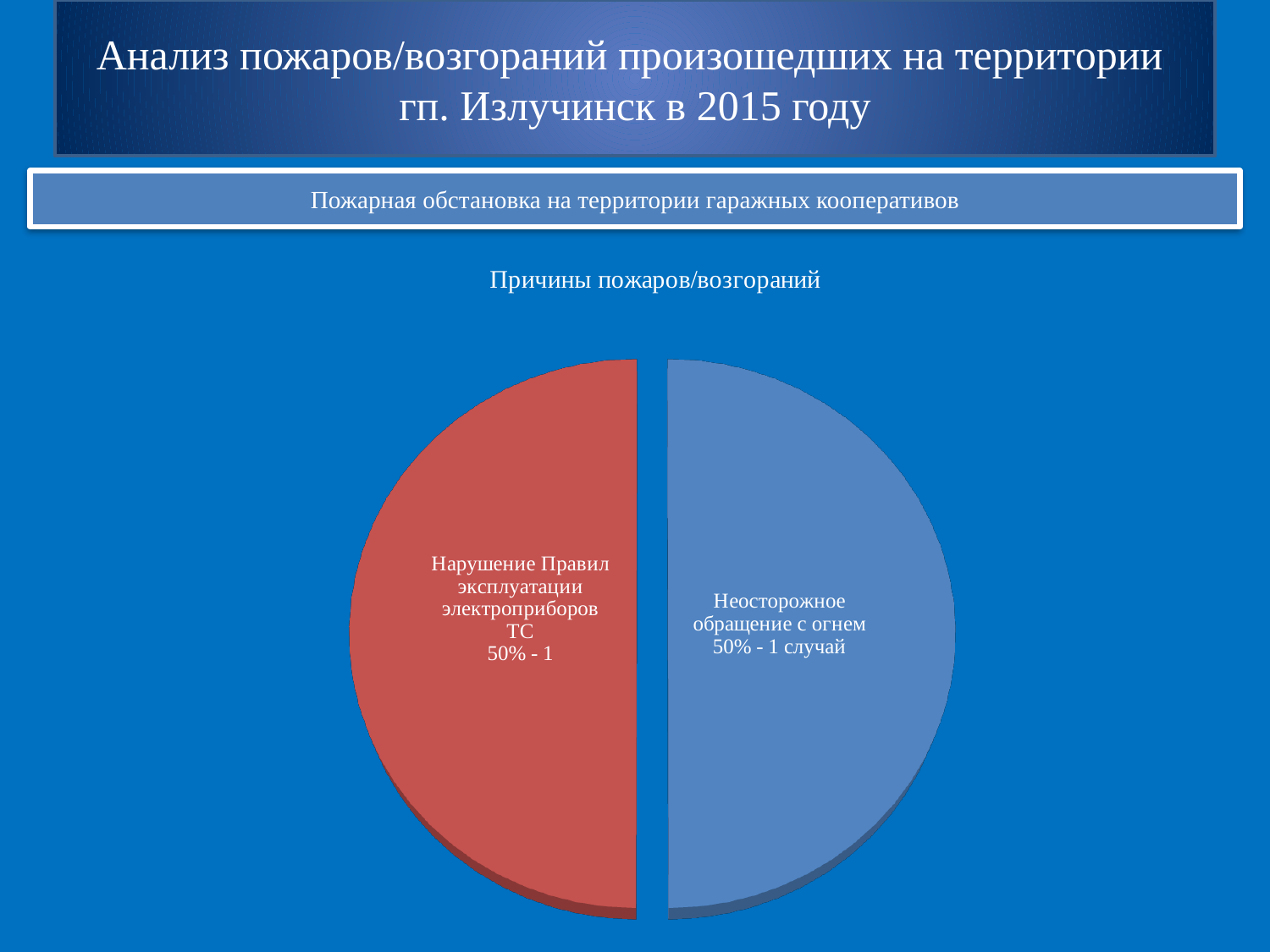
What kind of chart is shown on the slide? pie chart What share of the pie does the slice "Неосторожное обращение с огнем" represent? 50% How many slices does the pie chart have? 2 How many cases are shown for "Нарушение Правил эксплуатации электроприборов ТС"? 1 What is the title of the chart? Причины пожаров/возгораний What is the total number of cases shown across both slices of the pie chart? 2 What colour is the slice for "Неосторожное обращение с огнем"? blue What is the difference in percentage between the two slices of the pie chart? 0% How many cases are shown for "Неосторожное обращение с огнем"? 1 случай What share of the pie does the slice "Нарушение Правил эксплуатации электроприборов ТС" represent? 50%